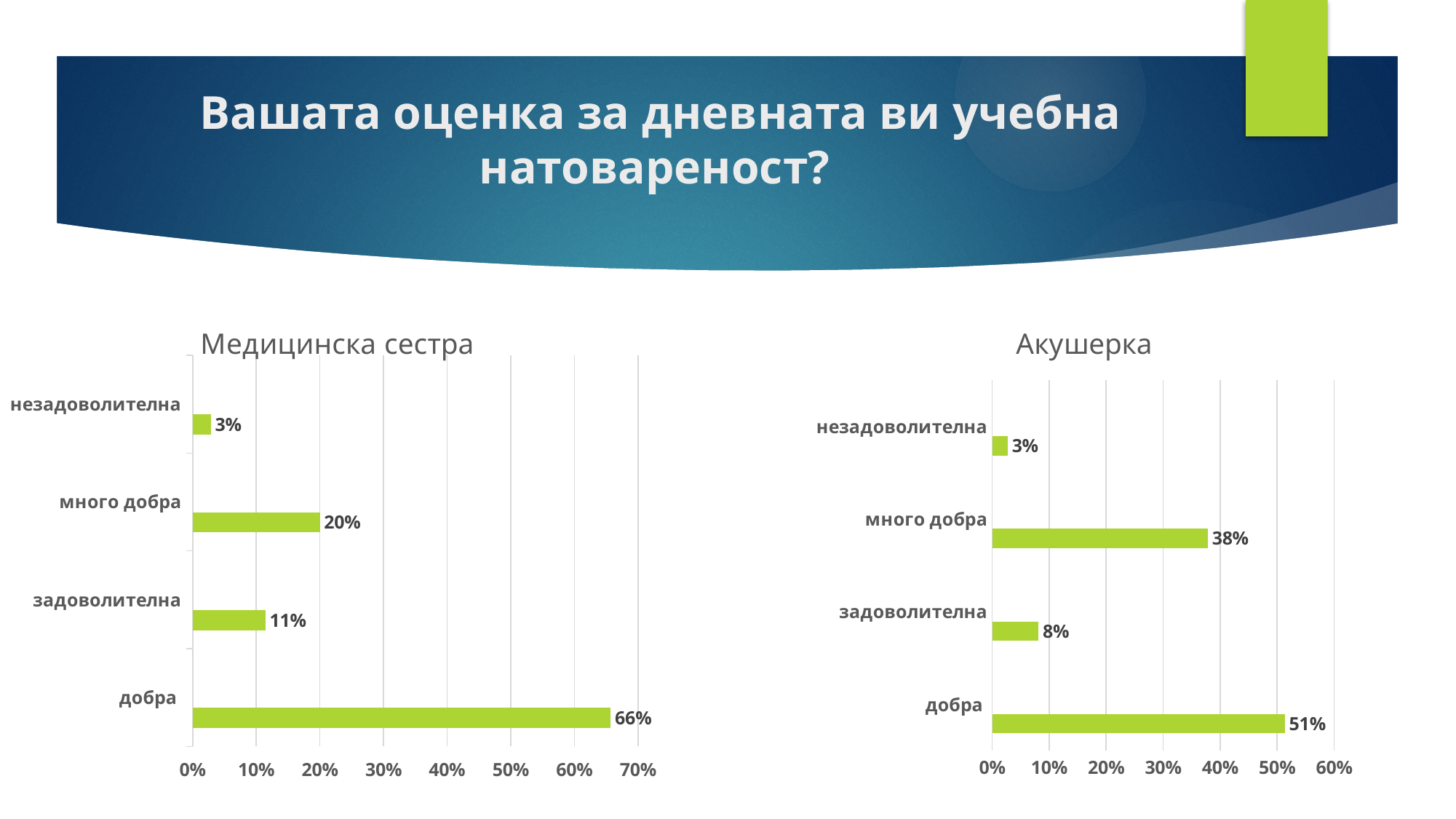
In the 'Акушерка' chart, which category has the highest value? добра In the 'Медицинска сестра' chart, which category has the lowest value? незадоволителна How many categories does the 'Медицинска сестра' chart show? 4 In the 'Медицинска сестра' chart, what is the value for 'добра'? 66% In the 'Медицинска сестра' chart, what is the difference between 'добра' and 'много добра'? 46% In the 'Акушерка' chart, what is the difference between 'добра' and 'много добра'? 13% In the 'Акушерка' chart, is the value for 'добра' greater or less than 50%? greater Which is larger: 'много добра' in the 'Медицинска сестра' chart or 'много добра' in the 'Акушерка' chart? Акушерка What is the title of the chart on the left? Медицинска сестра What kind of chart is the 'Акушерка' chart? bar chart In the 'Медицинска сестра' chart, what is the value for 'задоволителна'? 11% In the 'Акушерка' chart, what is the value for 'много добра'? 38%